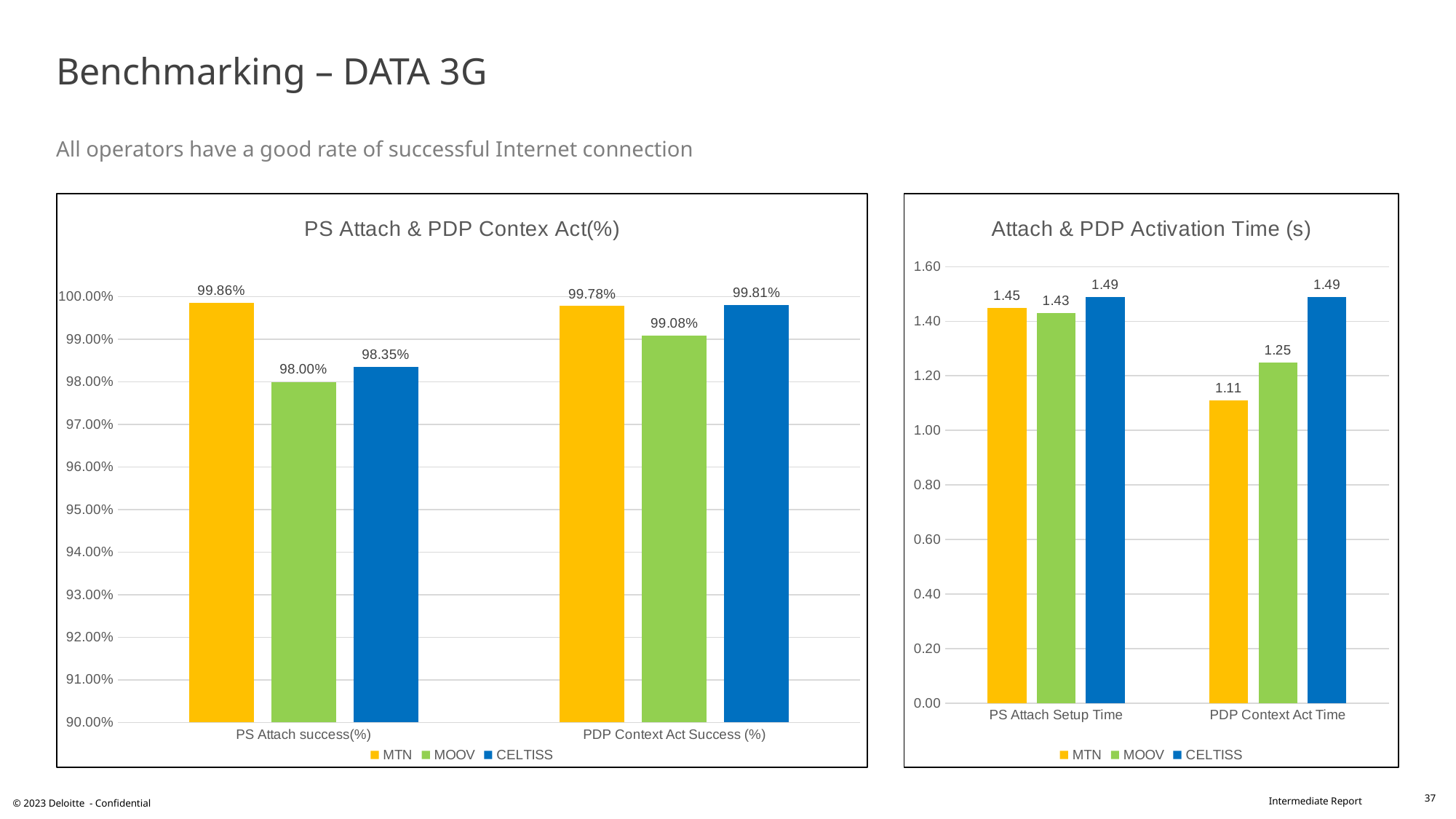
In the 'Attach & PDP Activation Time (s)' chart, which operator has the highest PDP Context Act Time? CELTISS In the 'Attach & PDP Activation Time (s)' chart, how many categories are shown on the x axis? 2 In the 'PS Attach & PDP Contex Act(%)' chart, how many series does the legend list? 3 What kind of chart is the 'Attach & PDP Activation Time (s)' chart? Bar chart In the 'Attach & PDP Activation Time (s)' chart, what is the value for MTN in PDP Context Act Time? 1.11 In the 'PS Attach & PDP Contex Act(%)' chart, what is the value for MTN in PS Attach success(%)? 99.86% In the 'Attach & PDP Activation Time (s)' chart, what is the difference between CELTISS and MOOV in PDP Context Act Time? 0.24 Which colour represents CELTISS in the charts? Blue In the 'Attach & PDP Activation Time (s)' chart, is the PS Attach Setup Time for MOOV larger or smaller than the PDP Context Act Time for MOOV? Larger In the 'PS Attach & PDP Contex Act(%)' chart, what is the value for MOOV in PDP Context Act Success (%)? 99.08% In the 'PS Attach & PDP Contex Act(%)' chart, which operator has the lowest PS Attach success(%)? MOOV In the 'PS Attach & PDP Contex Act(%)' chart, what is the difference between MTN and CELTISS in PS Attach success(%)? 1.51%